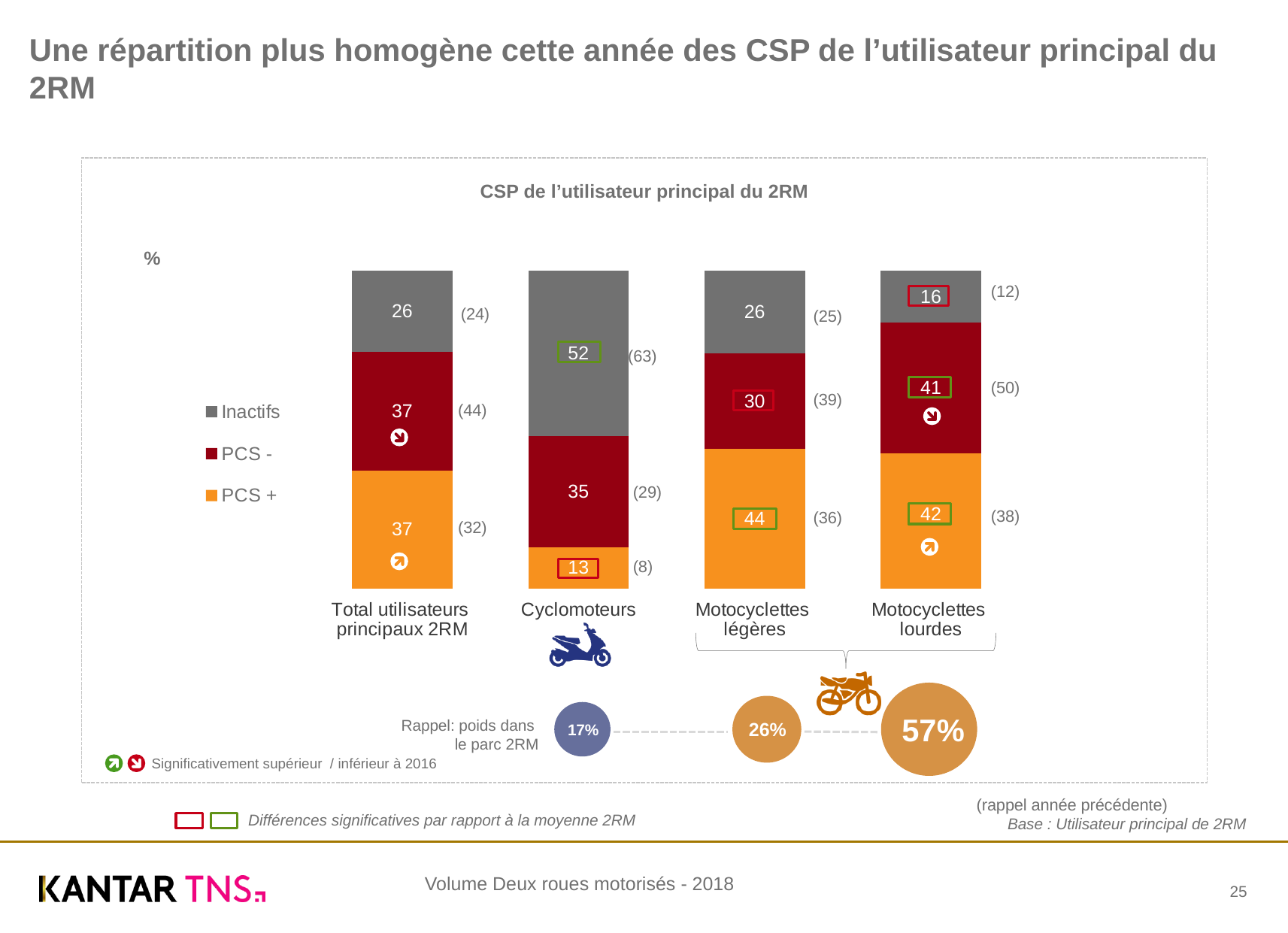
What is the difference between the PCS + value for Motocyclettes légères and the PCS + value for Cyclomoteurs? 31 Which category has the lowest PCS + value? Cyclomoteurs How many categories are shown on the x axis of the chart? 4 What is the title of the chart? CSP de l’utilisateur principal du 2RM What is the total of the stacked bar for Motocyclettes lourdes? 99 Which is larger: the PCS - value for Total utilisateurs principaux 2RM or the PCS - value for Motocyclettes légères? Total utilisateurs principaux 2RM What type of chart is shown on the slide? Stacked bar chart What is the PCS + value for Motocyclettes légères? 44 How many series does the legend list? 3 What is the Inactifs value for Cyclomoteurs? 52 What is the PCS - value for Motocyclettes lourdes? 41 Which category has the highest Inactifs value? Cyclomoteurs